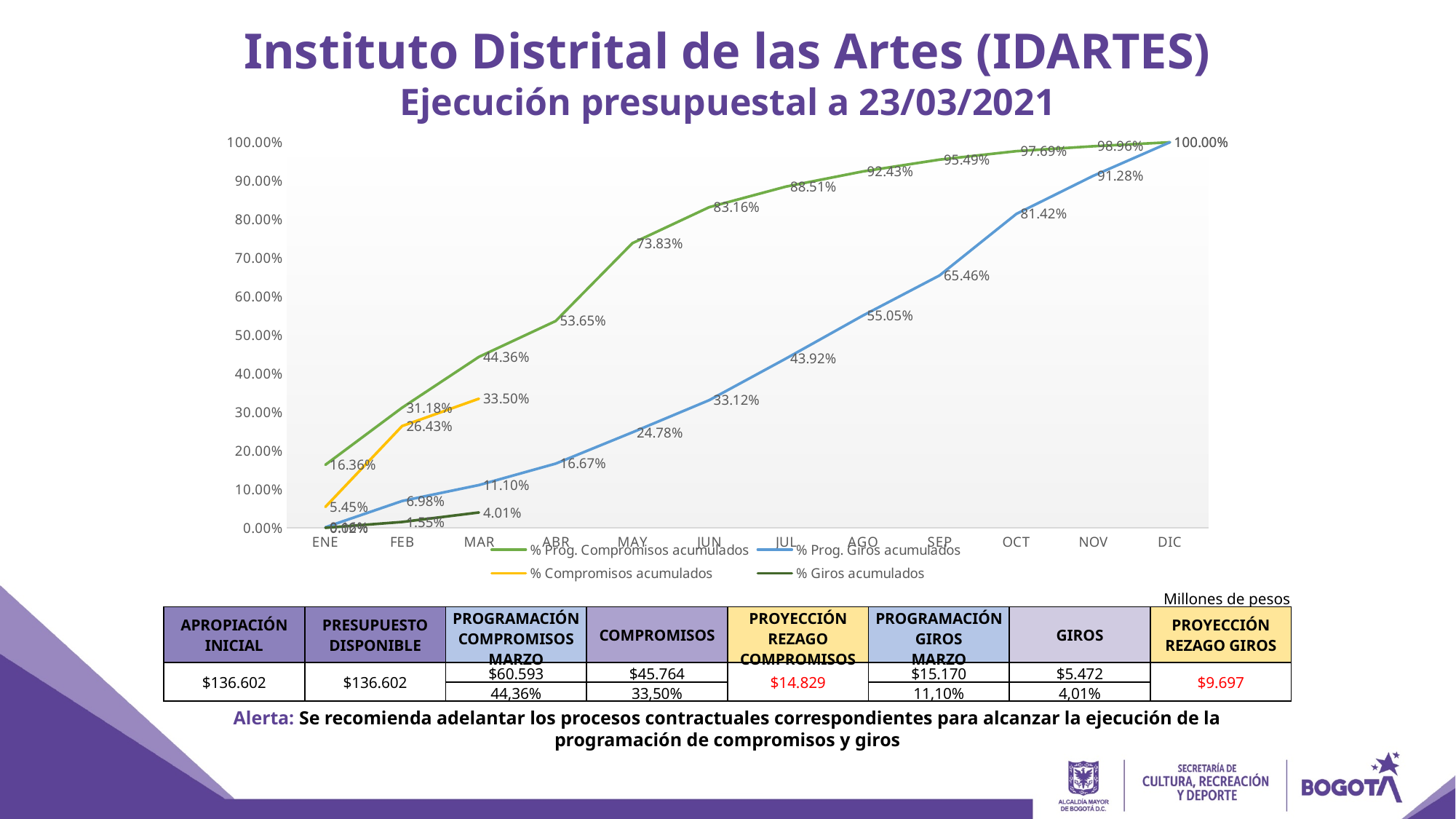
Which is larger in FEB: % Prog. Giros acumulados or % Compromisos acumulados? % Compromisos acumulados Does the % Prog. Giros acumulados series rise or fall from ENE to DIC? rise In which month does % Prog. Compromisos acumulados reach its highest value? DIC What is the value of % Prog. Giros acumulados for OCT? 81.42% What is the difference between % Prog. Compromisos acumulados and % Compromisos acumulados in MAR? 10.86% How many series does the chart legend list? 4 What is the value of % Giros acumulados for FEB? 1.55% What is the value of % Prog. Compromisos acumulados for MAY? 73.83% How many months are shown on the x axis of the chart? 12 Which series is drawn in yellow in the chart? % Compromisos acumulados What is the value of % Compromisos acumulados for MAR? 33.50% What kind of chart is shown on the slide? line chart